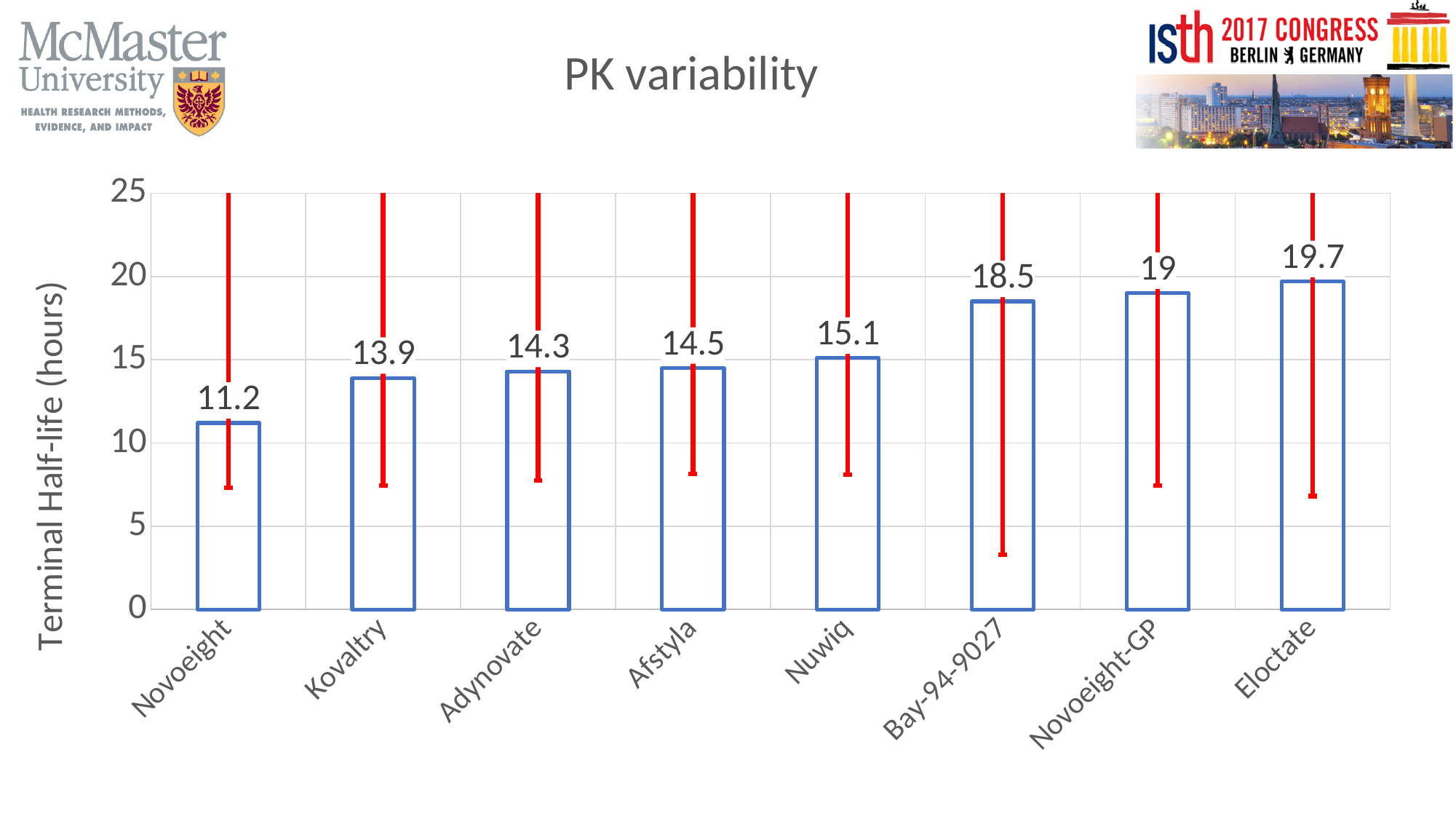
What is the terminal half-life value shown for Novoeight? 11.2 What kind of chart is shown on the slide? bar chart What is the difference between the terminal half-life of Bay-94-9027 and Adynovate? 4.2 Is the terminal half-life for Bay-94-9027 greater or less than 15? greater Which product has the highest terminal half-life? Eloctate What is the difference between the terminal half-life of Eloctate and Novoeight? 8.5 What is the terminal half-life value shown for Novoeight-GP? 19 What is the terminal half-life value shown for Nuwiq? 15.1 How many products are shown on the chart? 8 Which has a larger terminal half-life, Kovaltry or Afstyla? Afstyla Which product has the lowest terminal half-life? Novoeight What is the title of the chart? PK variability